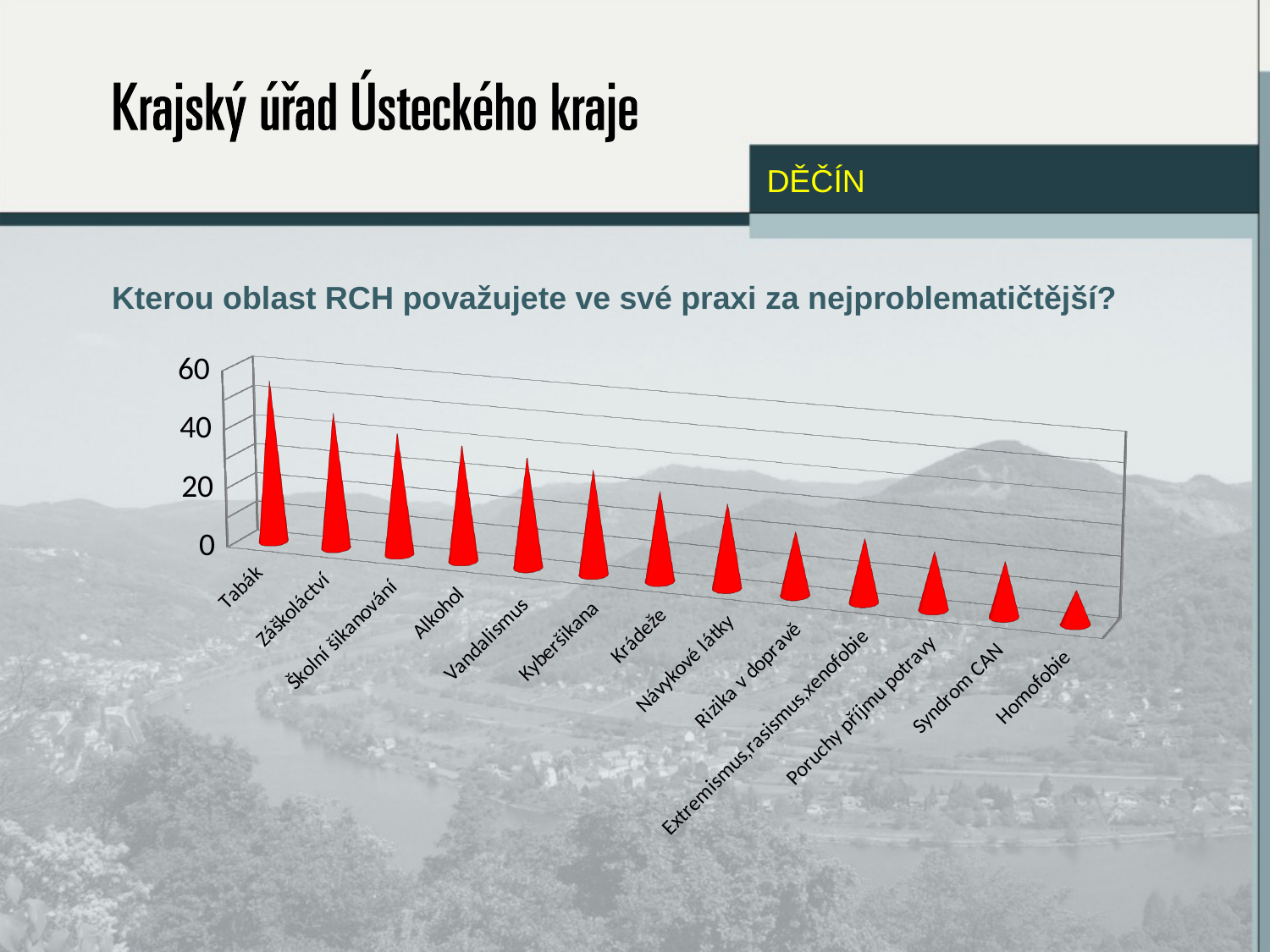
Do the values rise or fall moving from left to right along the x axis? fall What kind of chart is shown on the slide? bar chart How many categories are shown on the x axis of the chart? 13 Which category has the highest value in the chart? Tabák Is the value for Záškoláctví greater or less than 20? greater Which is larger, the value for Alkohol or the value for Homofobie? Alkohol Is the value for Homofobie greater or less than 20? less Which is larger, the value for Záškoláctví or the value for Krádeže? Záškoláctví Which category has the lowest value in the chart? Homofobie What question is shown as the title above the chart? Kterou oblast RCH považujete ve své praxi za nejproblematičtější? Is the value for Tabák greater or less than 40? greater